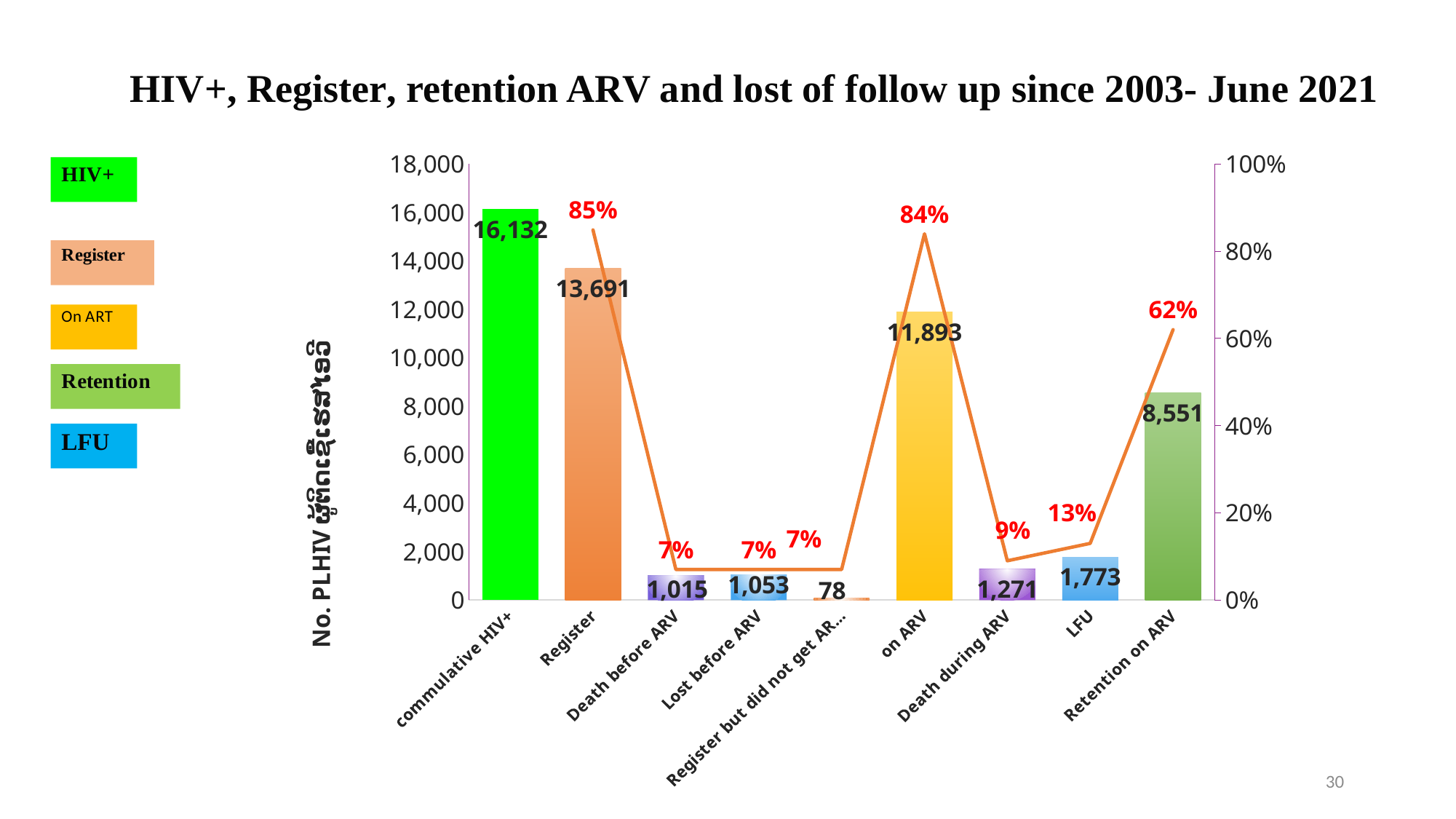
Which bar is larger, Death during ARV or LFU? LFU Which category has the lowest bar? Register but did not get AR... What is the difference between the bar values for commulative HIV+ and Register? 2,441 How many categories are shown on the x axis? 9 What is the title of the chart? HIV+, Register, retention ARV and lost of follow up since 2003- June 2021 What is the value of the bar for Retention on ARV? 8,551 Which category has the highest bar? commulative HIV+ What is the value of the bar for Register? 13,691 What is the value of the bar for LFU? 1,773 What percentage is shown on the line for Retention on ARV? 62% What is the value of the bar for on ARV? 11,893 What percentage is shown on the line for on ARV? 84%